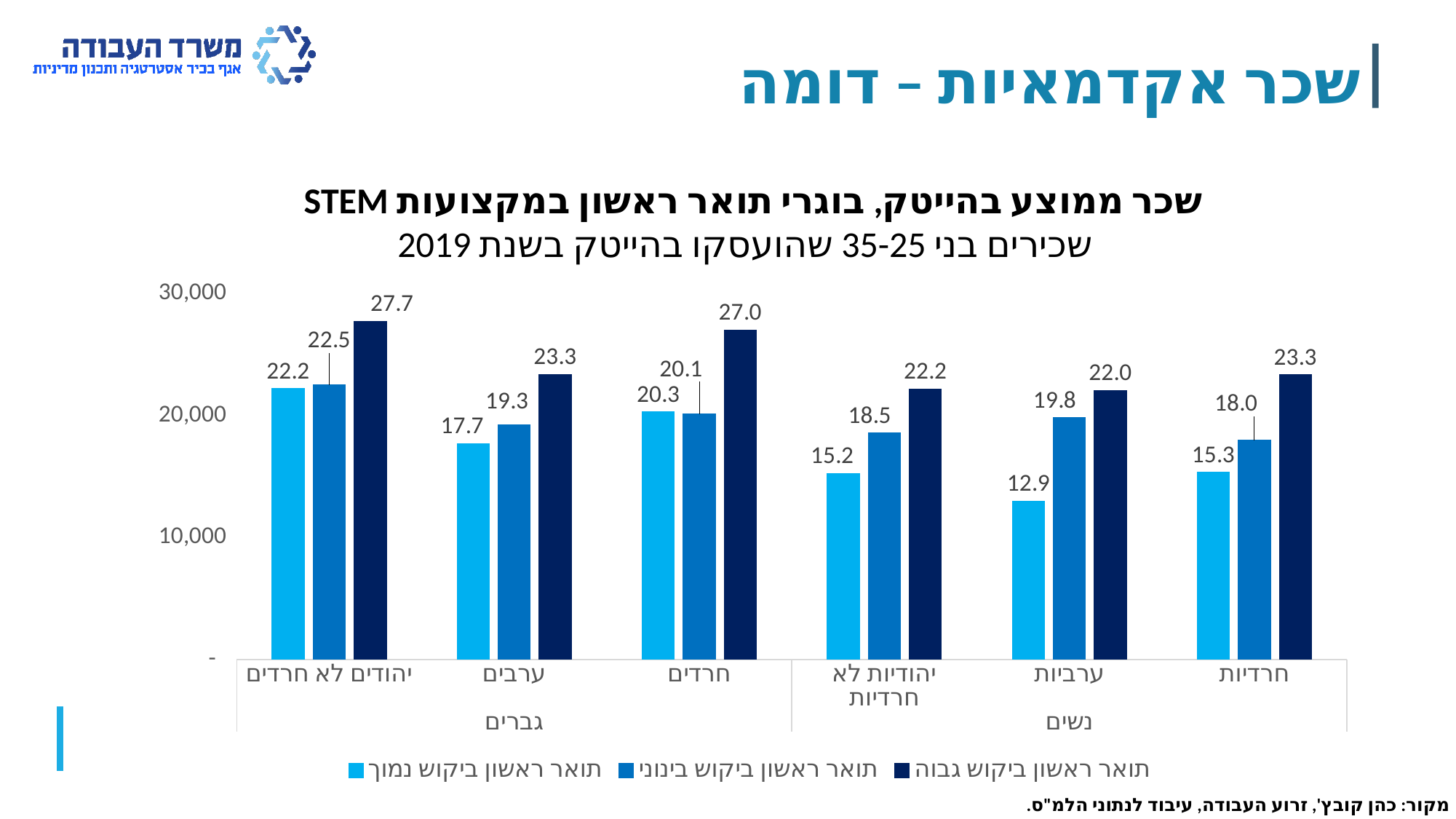
What is the value for תואר ראשון ביקוש גבוה for יהודים לא חרדים (men)? 27.7 What type of chart is shown on the slide? bar chart Is the bar for תואר ראשון ביקוש נמוך for יהודיות לא חרדיות greater or less than 20,000? less What is the value for תואר ראשון ביקוש בינוני for חרדים (men)? 20.1 Which category has the lowest value for תואר ראשון ביקוש נמוך? ערביות Which is larger for ערבים (men): the value for תואר ראשון ביקוש בינוני or for תואר ראשון ביקוש נמוך? תואר ראשון ביקוש בינוני What is the difference between the תואר ראשון ביקוש גבוה and תואר ראשון ביקוש נמוך values for חרדיות (women)? 8.0 How many series does the legend list? 3 What is the value for תואר ראשון ביקוש נמוך for ערביות (women)? 12.9 Which colour represents the series תואר ראשון ביקוש גבוה in the legend? dark navy blue Which category has the highest value for תואר ראשון ביקוש גבוה? יהודים לא חרדים How many categories are shown along the x axis? 6